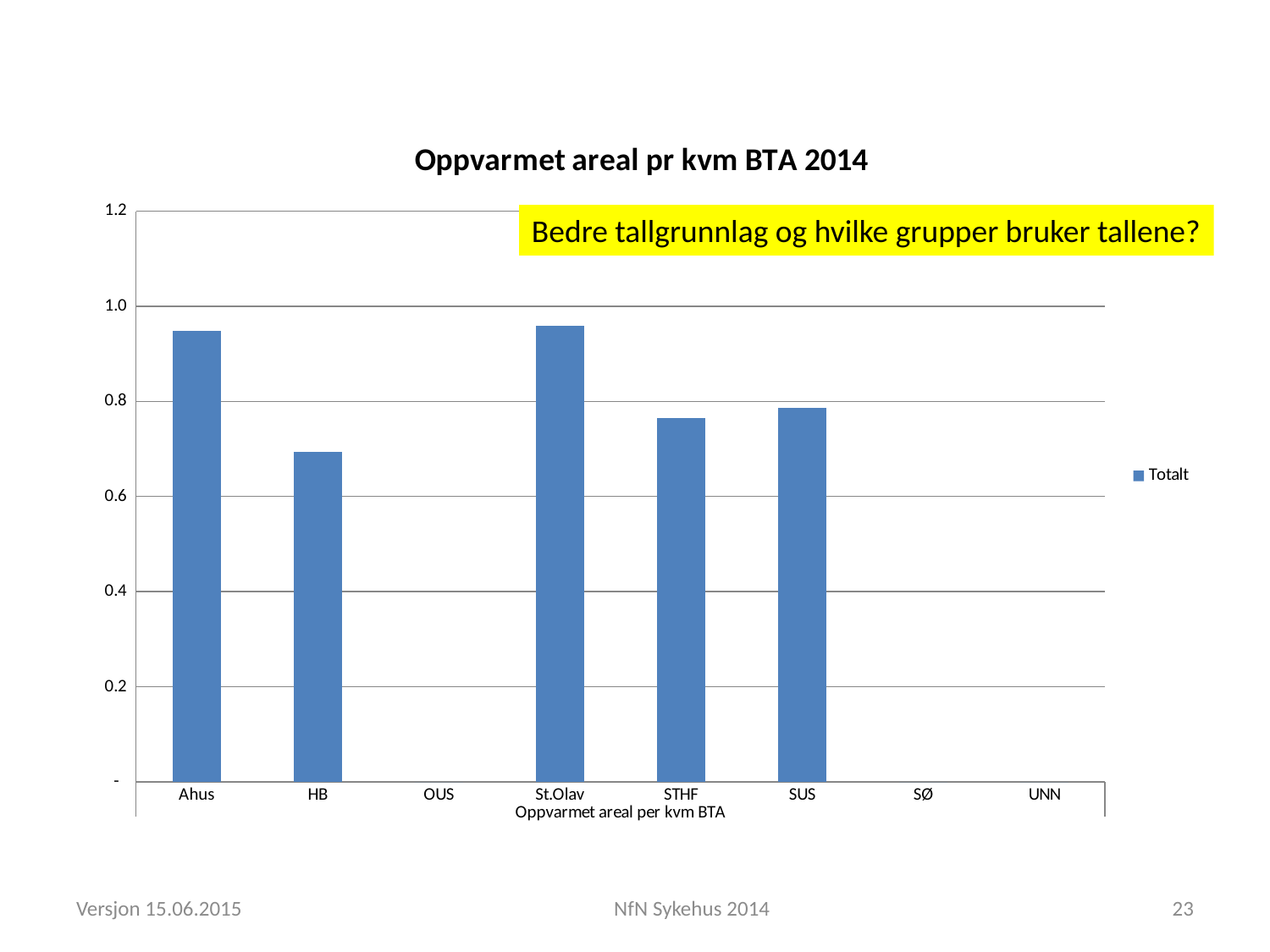
Is the value for STHF greater or less than 0.6? greater Which is larger, the value for St.Olav or the value for STHF? St.Olav Which is larger, the value for Ahus or the value for HB? Ahus How many categories are shown on the x axis? 8 What is the name of the series shown in the legend? Totalt Is the value for HB greater or less than 0.8? less Is the value for St.Olav greater or less than 1.0? less What is the title of the chart? Oppvarmet areal pr kvm BTA 2014 What kind of chart is shown on the slide? bar chart How many series does the legend list? 1 Among the categories with a visible bar, which has the lowest value? HB